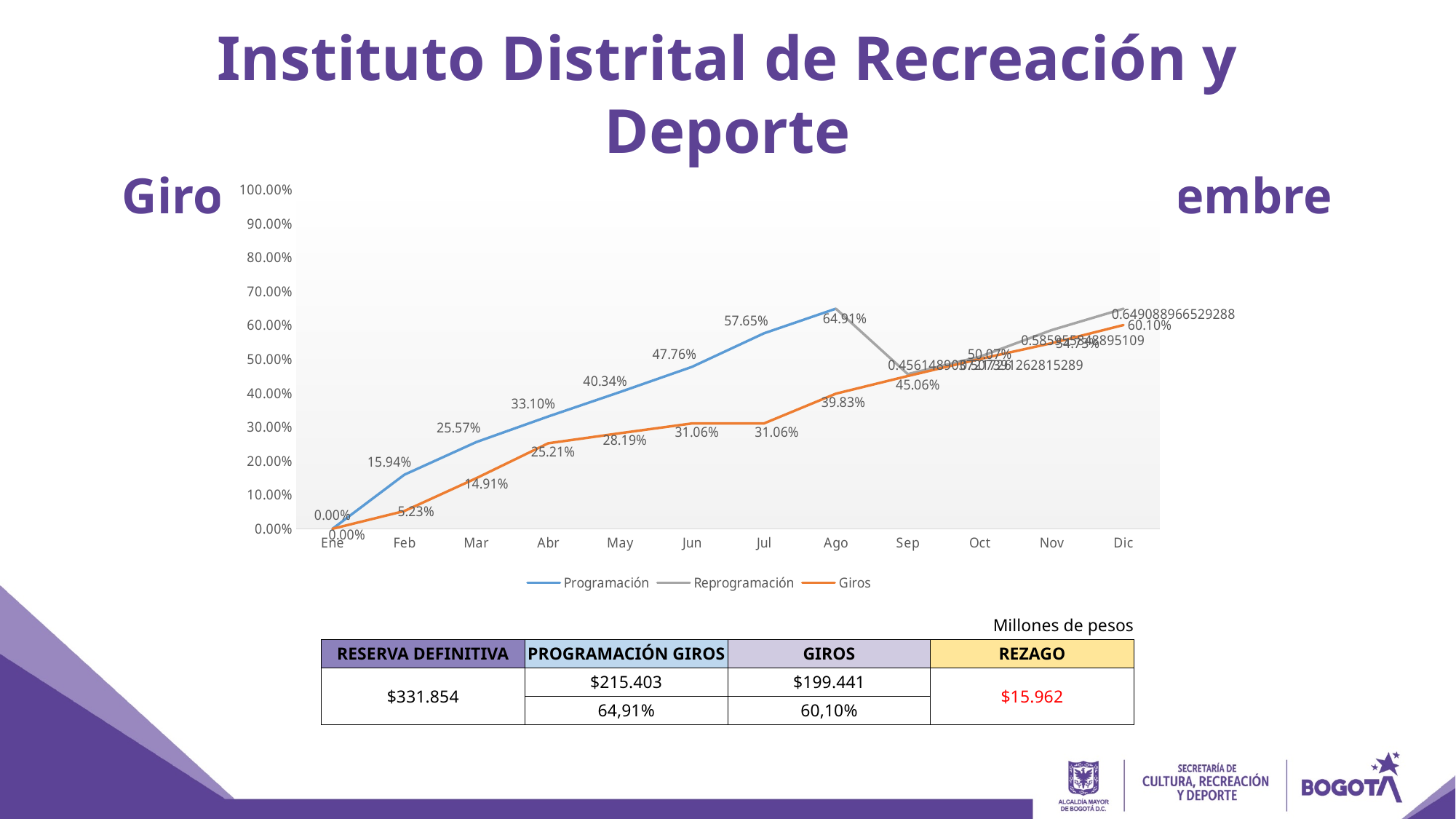
How many series does the chart legend list? 3 Is the Giros value for Sep greater or less than 40.00%? greater Which is larger in Jun, the Programación value or the Giros value? Programación Which series is drawn in orange in the chart? Giros What is the difference between the Programación value and the Giros value for Ago? 25.08% What is the Programación value for May? 40.34% What is the Giros value for Feb? 5.23% Does the Giros series rise or fall from Ene to Dic? rise What kind of chart is shown on the slide? line chart How many months are shown on the x axis of the chart? 12 What is the Programación value for Ago? 64.91% What is the Giros value for Dic? 60.10%